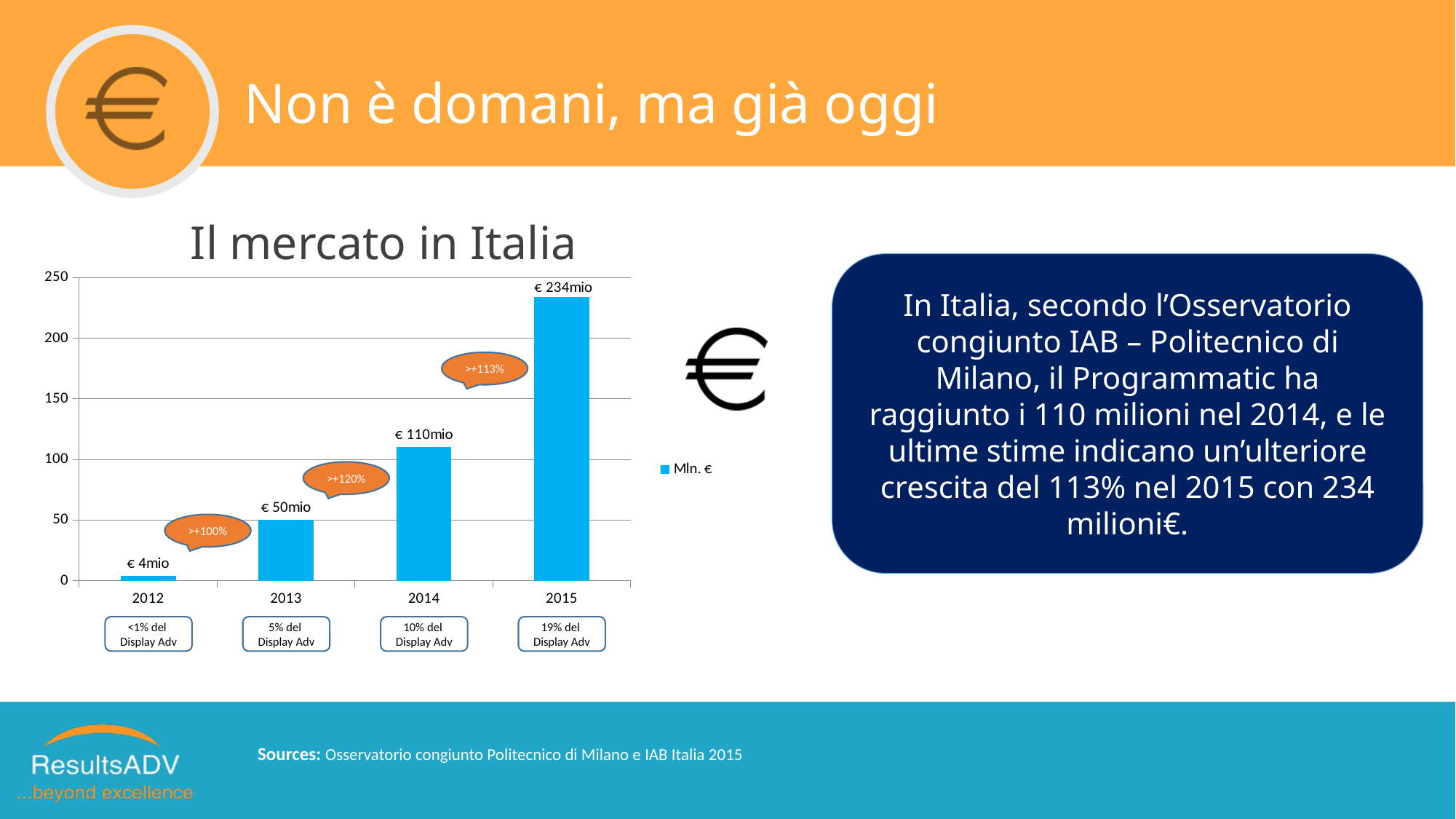
What is the value for 2014? € 110mio How many years are shown on the x axis? 4 What is the value for 2012? € 4mio Which is larger, the value for 2013 or the value for 2014? 2014 Which year has the lowest value? 2012 What is the value for 2015? € 234mio What is the difference between the values for 2015 and 2014? € 124mio What kind of chart is shown? bar chart How many series does the legend list? 1 Do the values rise or fall from 2012 to 2015? rise Which year has the highest value? 2015 Is the value for 2015 greater or less than 200? greater